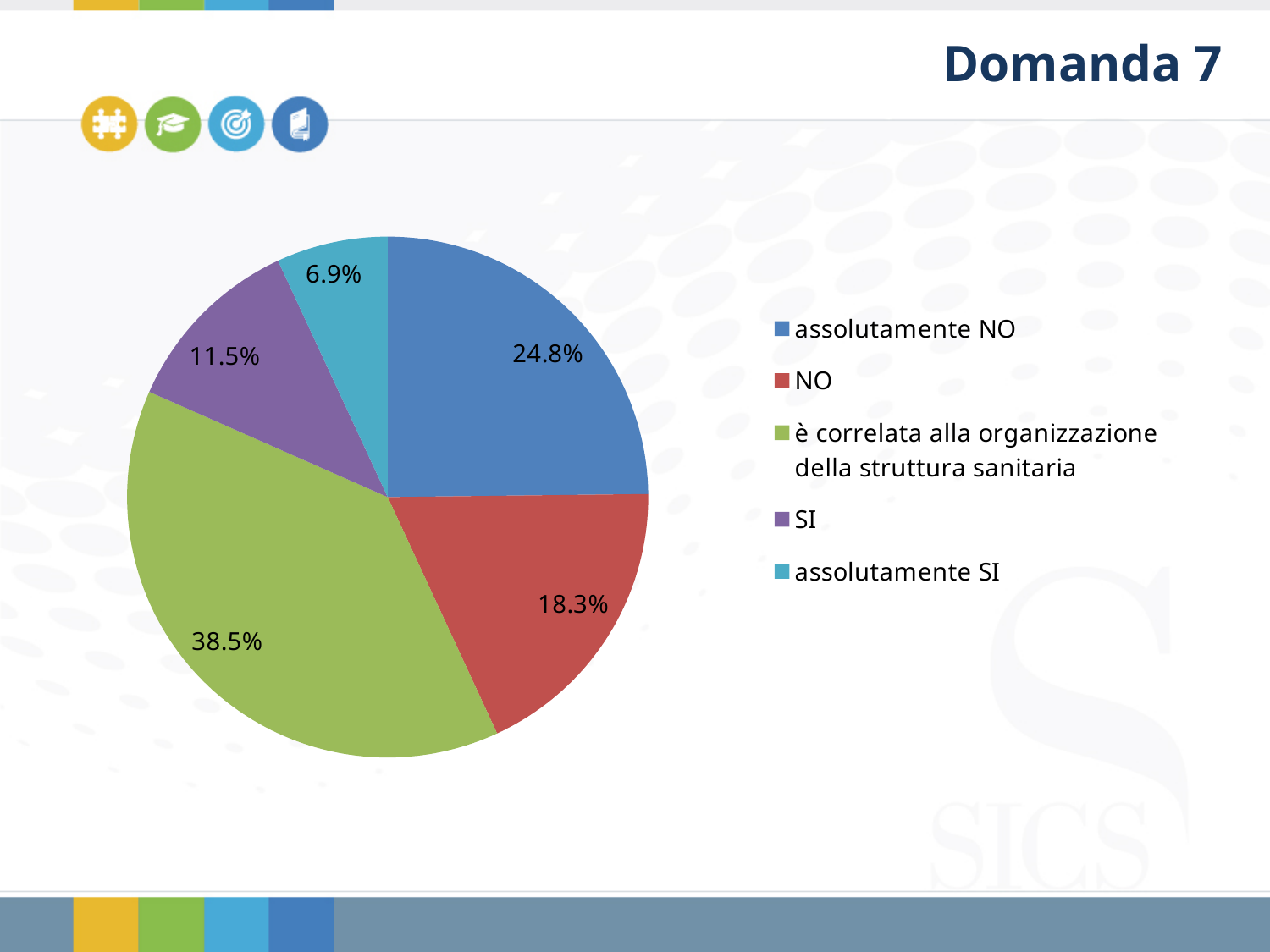
Which is larger, the value for "SI" or the value for "assolutamente SI"? SI Which category has the largest slice of the pie? è correlata alla organizzazione della struttura sanitaria What is the value shown for "NO"? 18.3% Which category has the smallest slice of the pie? assolutamente SI What is the value shown for "SI"? 11.5% What kind of chart is shown on the slide? pie chart What share of the pie does "assolutamente NO" represent? 24.8% What colour is the slice for "NO"? red What is the difference between the values for "assolutamente NO" and "NO"? 6.5% What is the value shown for "è correlata alla organizzazione della struttura sanitaria"? 38.5% What is the value shown for "assolutamente SI"? 6.9% How many categories does the pie chart have? 5